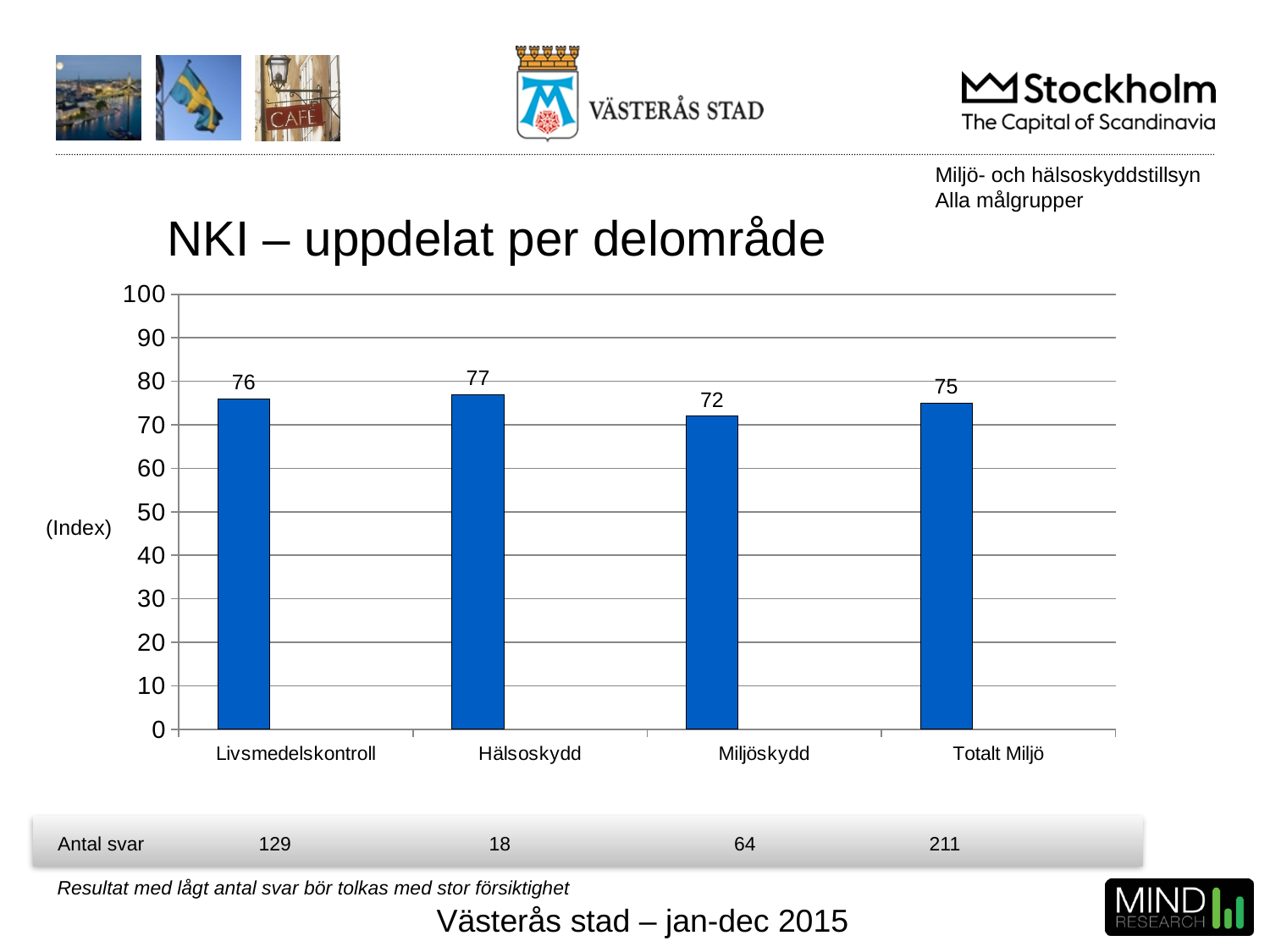
What is the NKI value for Livsmedelskontroll? 76 How many categories are shown on the x axis of the chart? 4 What is the NKI value for Totalt Miljö? 75 Is the value for Miljöskydd greater or less than 80? less What is the difference between the NKI values for Hälsoskydd and Miljöskydd? 5 What is the title of the chart? NKI – uppdelat per delområde Which category has the highest NKI value? Hälsoskydd What is the NKI value for Miljöskydd? 72 What kind of chart is shown on the slide? bar chart Which is larger, the NKI value for Livsmedelskontroll or for Totalt Miljö? Livsmedelskontroll What is the NKI value for Hälsoskydd? 77 Which category has the lowest NKI value? Miljöskydd